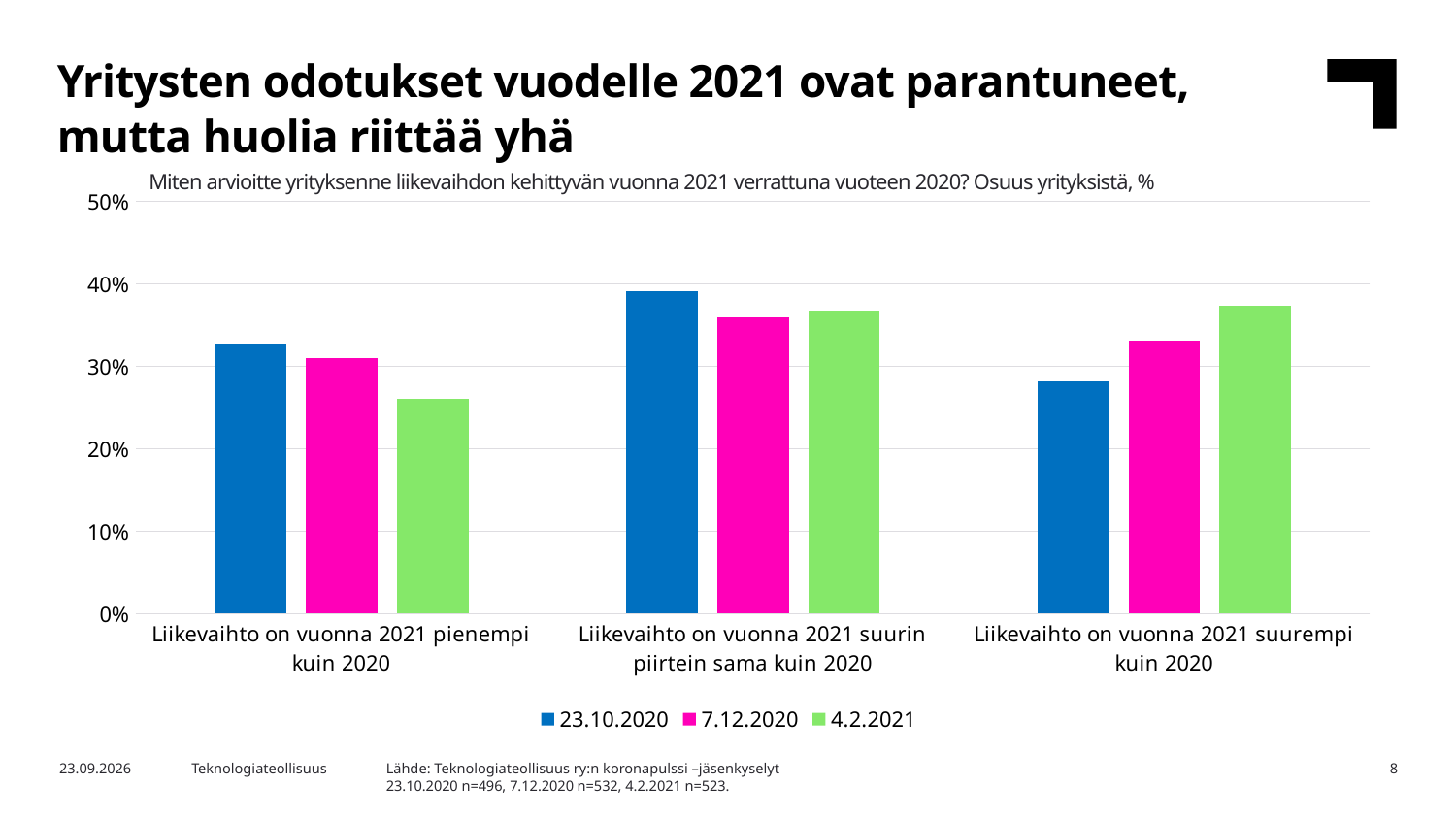
How many categories are shown on the x axis? 3 How many series does the legend list? 3 Is the value for 23.10.2020 in the category "Liikevaihto on vuonna 2021 suurempi kuin 2020" greater or less than 30%? less In the category "Liikevaihto on vuonna 2021 suurempi kuin 2020", which is larger: the value for 23.10.2020 or for 4.2.2021? 4.2.2021 Is the value for 4.2.2021 in the category "Liikevaihto on vuonna 2021 suurempi kuin 2020" greater or less than 30%? greater Is the value for 4.2.2021 in the category "Liikevaihto on vuonna 2021 pienempi kuin 2020" greater or less than 30%? less For the 23.10.2020 series, which category has the highest value? Liikevaihto on vuonna 2021 suurin piirtein sama kuin 2020 In the category "Liikevaihto on vuonna 2021 pienempi kuin 2020", which is larger: the value for 23.10.2020 or for 4.2.2021? 23.10.2020 Which survey date is shown in pink in the legend? 7.12.2020 What kind of chart is shown on the slide? bar chart Across the three survey dates, do the values for "Liikevaihto on vuonna 2021 suurempi kuin 2020" rise or fall? rise